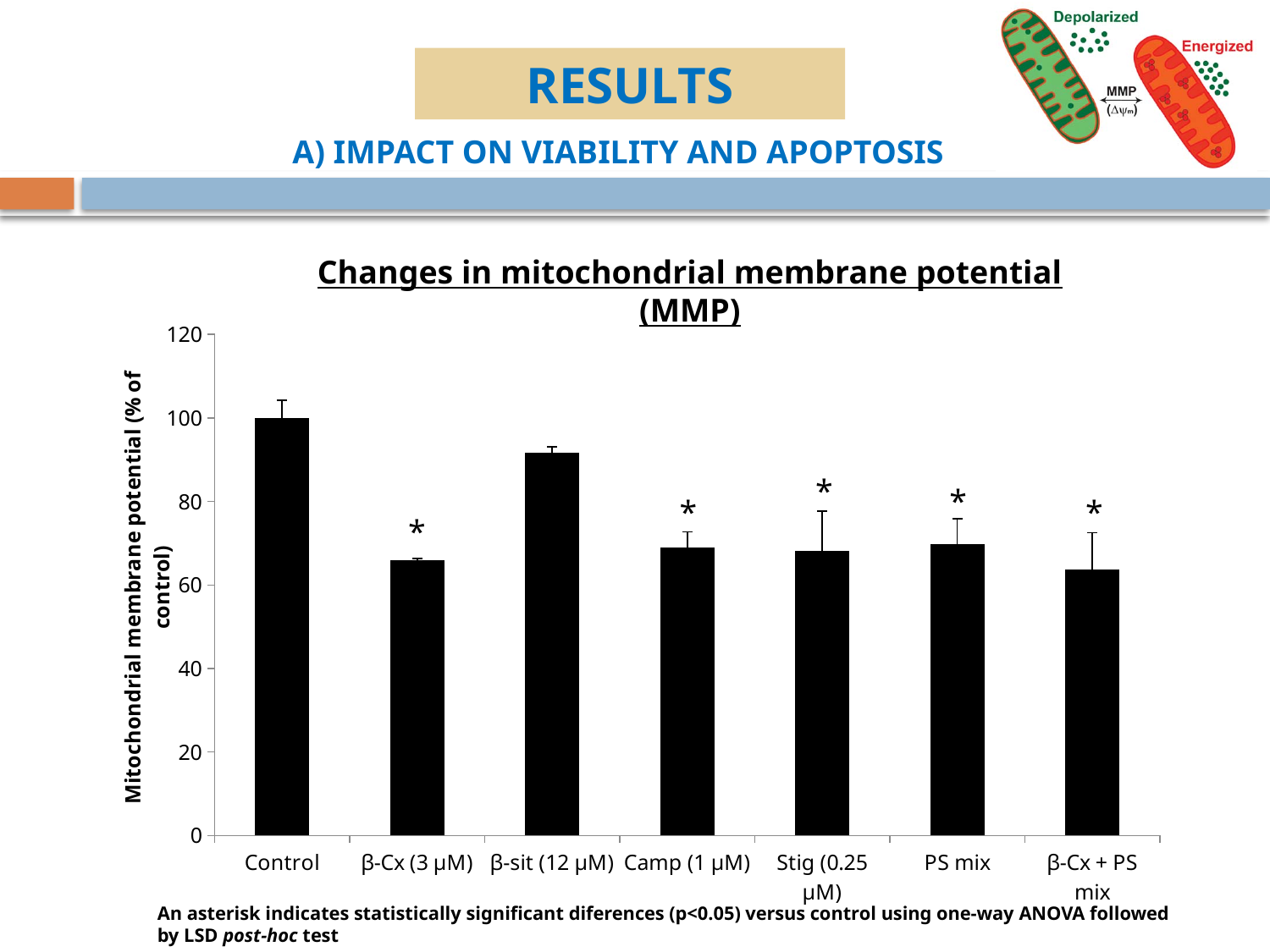
What kind of chart is shown on the slide? bar chart Is the value for β-sit (12 µM) greater or less than 80? greater What is the mitochondrial membrane potential value for Control? 100 What is the title of the chart? Changes in mitochondrial membrane potential (MMP) Is the value for β-Cx (3 µM) greater or less than 80? less Is the value for Camp (1 µM) greater or less than 80? less Which is larger, the value for Control or the value for β-Cx (3 µM)? Control Which category has the highest mitochondrial membrane potential? Control How many categories are plotted on the x axis of the chart? 7 What is the label of the y axis of the chart? Mitochondrial membrane potential (% of control) Which is larger, the value for β-sit (12 µM) or the value for Stig (0.25 µM)? β-sit (12 µM)